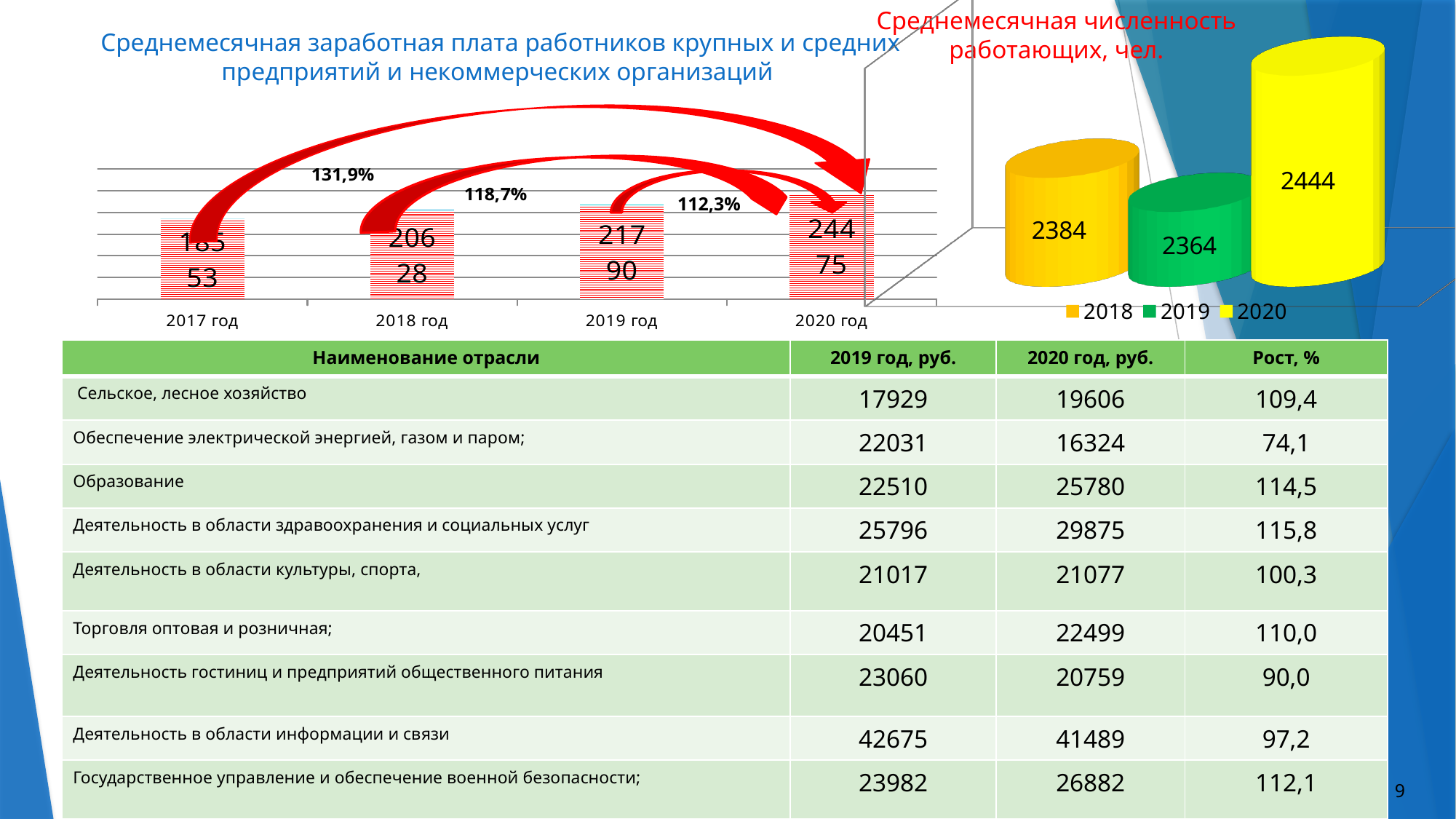
How many year categories are shown on the x axis of the left chart (Среднемесячная заработная плата)? 4 In the right chart "Среднемесячная численность работающих, чел.", which year has the lowest value? 2019 In the right chart "Среднемесячная численность работающих, чел.", what is the value for 2020? 2444 What kind of chart is the left chart titled "Среднемесячная заработная плата работников крупных и средних предприятий и некоммерческих организаций"? bar chart In the left chart (Среднемесячная заработная плата), what percentage label is shown between the 2019 год and 2020 год bars? 112,3% In the left chart (Среднемесячная заработная плата), what is the highest percentage label shown above the bars? 131,9% In the left chart (Среднемесячная заработная плата), which year has the highest bar? 2020 год In the right chart "Среднемесячная численность работающих, чел.", what is the difference between the 2020 value and the 2019 value? 80 In the left chart (Среднемесячная заработная плата), which year has the lowest bar? 2017 год In the right chart "Среднемесячная численность работающих, чел.", what is the value for 2018? 2384 In the left chart (Среднемесячная заработная плата), do the bar values rise or fall from 2017 год to 2020 год? rise How many entries does the legend of the right chart "Среднемесячная численность работающих, чел." list? 3